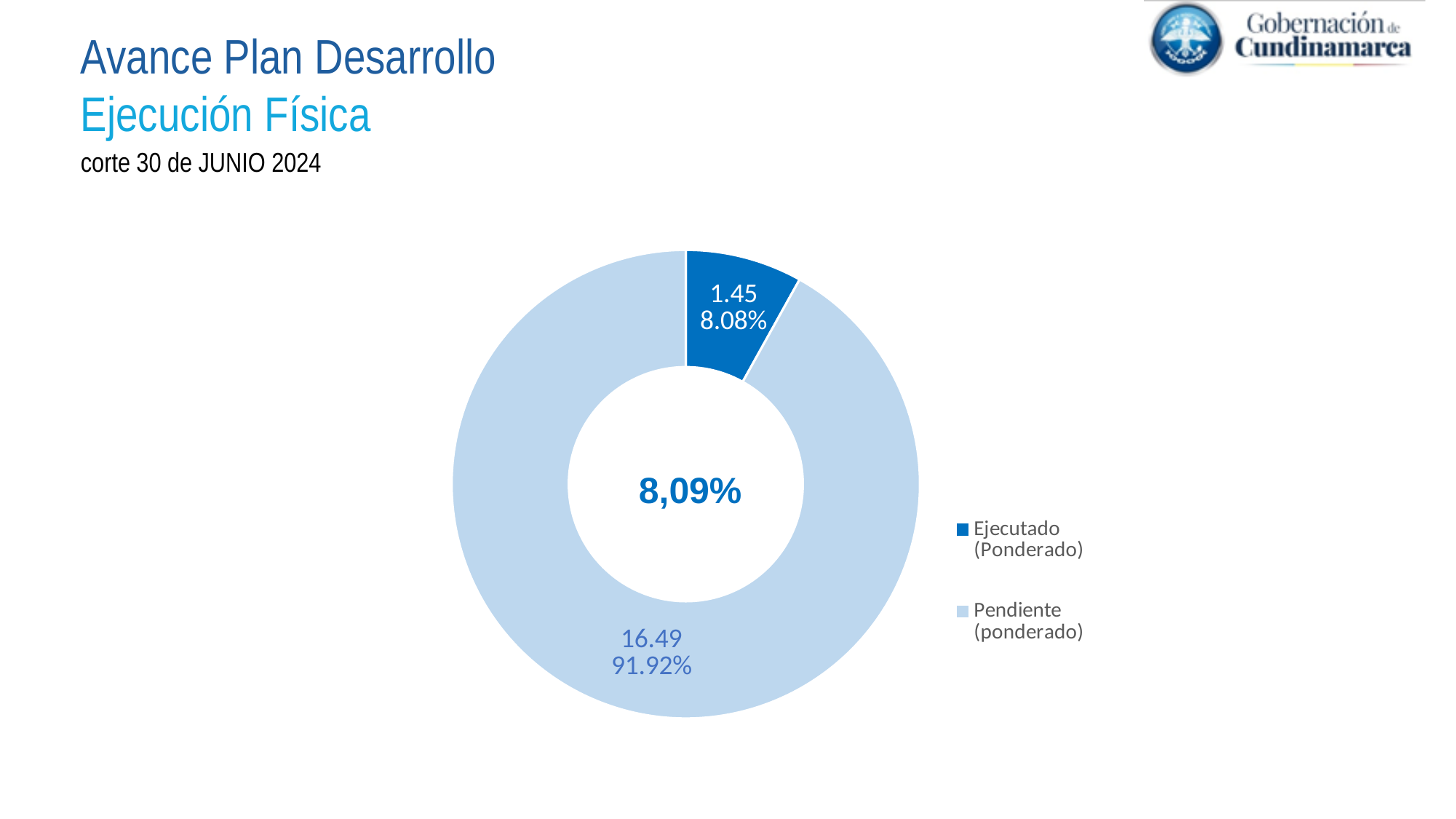
What kind of chart is shown on the slide? Doughnut (pie) chart What share of the chart does the Ejecutado (Ponderado) slice represent? 8.08% Which category has the largest slice? Pendiente (ponderado) What is the value for Pendiente (ponderado)? 16.49 Which is larger, the Ejecutado (Ponderado) slice or the Pendiente (ponderado) slice? Pendiente (ponderado) How many categories does the chart show? 2 What share of the chart does the Pendiente (ponderado) slice represent? 91.92% What is the difference between the Pendiente (ponderado) value and the Ejecutado (Ponderado) value? 15.04 What is the value for Ejecutado (Ponderado)? 1.45 What percentage is printed in the centre of the doughnut chart? 8,09% Which category has the smallest slice? Ejecutado (Ponderado) What colour is the Ejecutado (Ponderado) slice? Dark blue